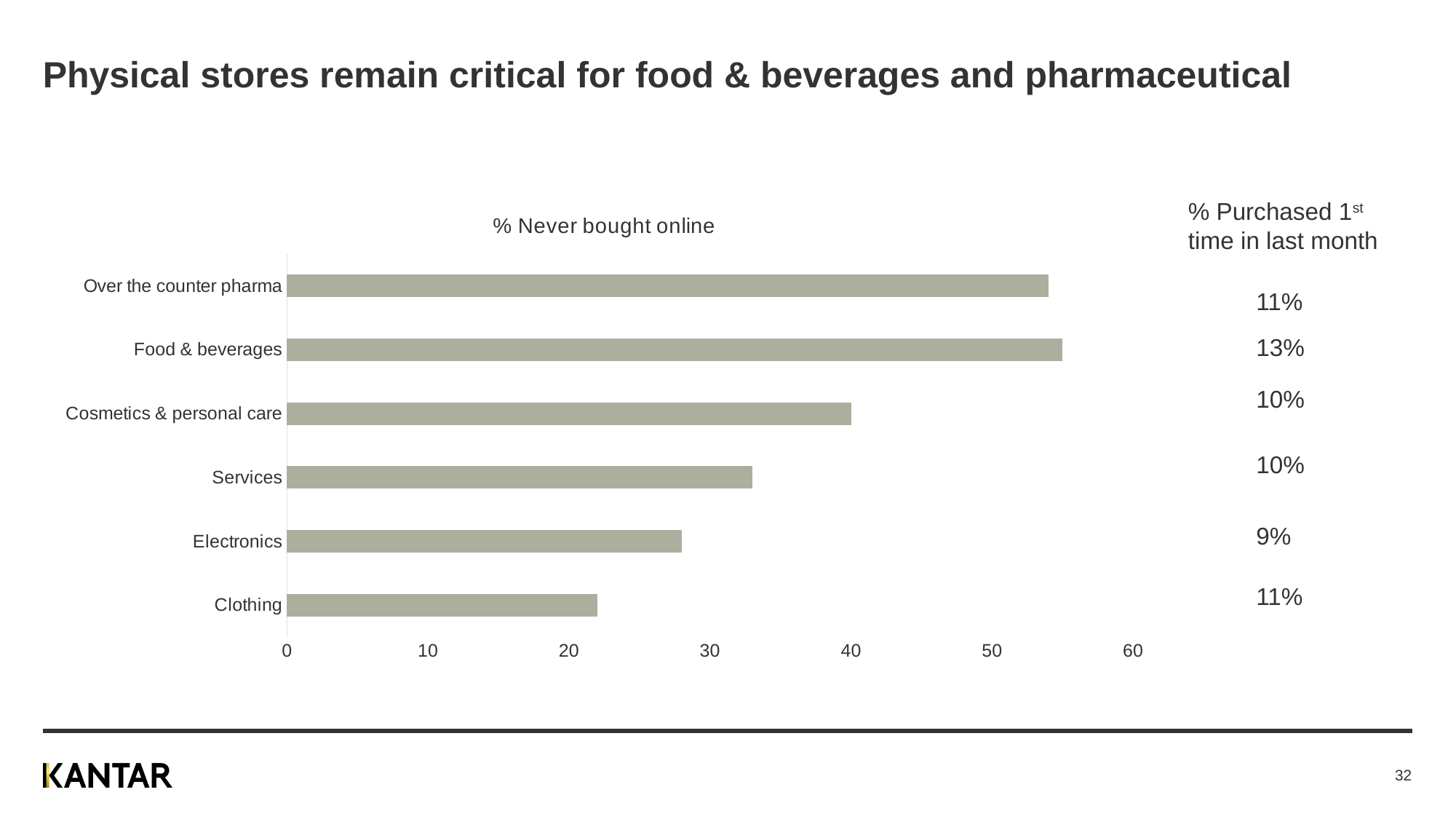
Which has a higher % never bought online, Cosmetics & personal care or Clothing? Cosmetics & personal care Is the value for Over the counter pharma greater or less than 50? greater Is the value for Clothing greater or less than 20? greater Is the value for Services greater or less than 30? greater What is the highest value shown on the horizontal axis of the chart? 60 Which has a higher % never bought online, Services or Electronics? Services What kind of chart is shown on the slide? bar chart How many categories are plotted in the chart? 6 What is the title of the chart? % Never bought online Which category has the lowest % never bought online? Clothing